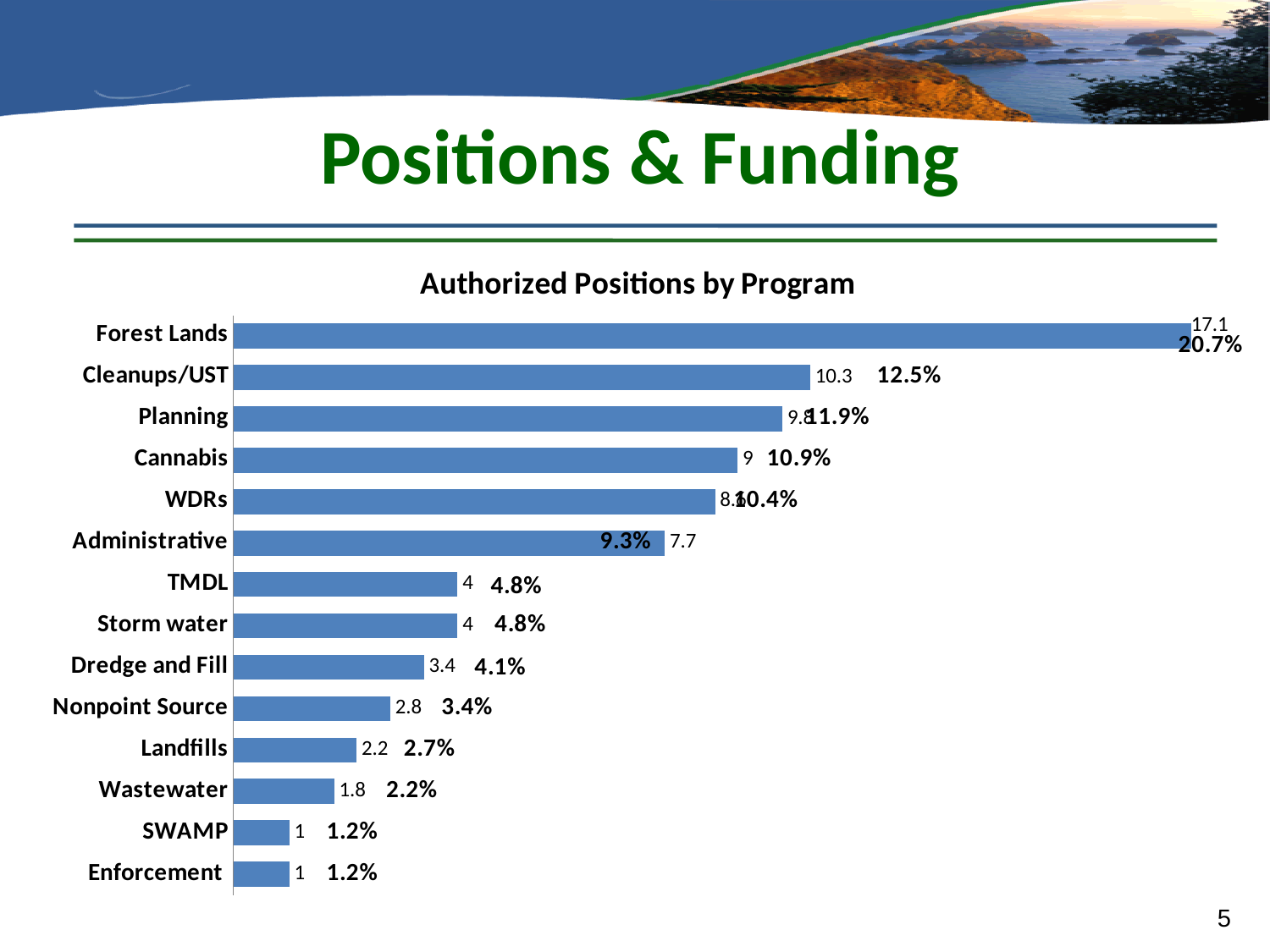
What type of chart is shown on the slide? bar chart What percentage is shown for Wastewater? 2.2% How many authorized positions does Cleanups/UST have? 10.3 Which has more authorized positions, Dredge and Fill or Nonpoint Source? Dredge and Fill What is the difference in authorized positions between Forest Lands and Cleanups/UST? 6.8 What percentage share is shown for Forest Lands? 20.7% Which program has the highest number of authorized positions? Forest Lands How many programs are shown in the chart? 14 What is the title of the chart? Authorized Positions by Program How many authorized positions does Administrative have? 7.7 How many authorized positions does Forest Lands have? 17.1 What percentage is shown for Cannabis? 10.9%